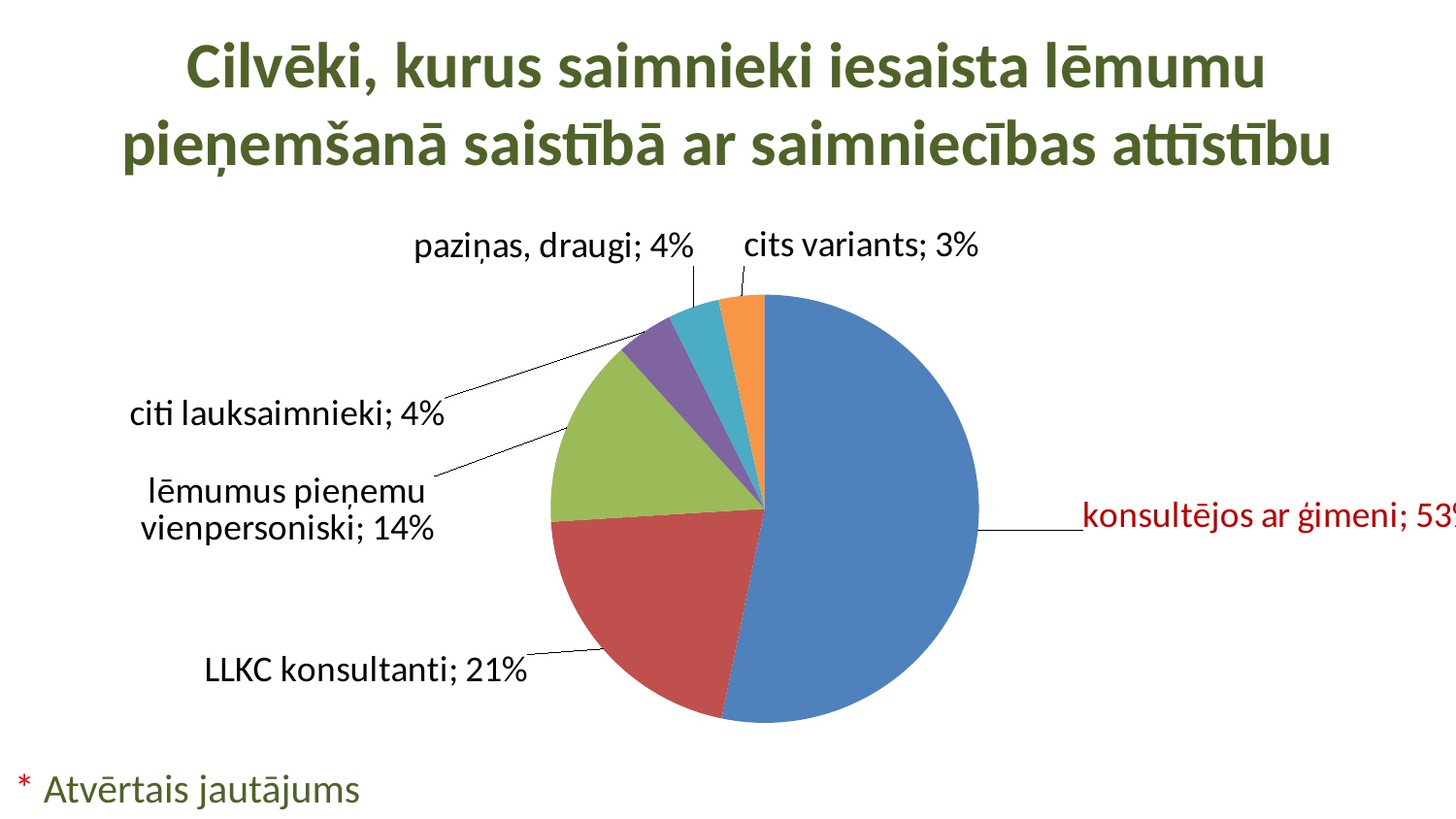
What share does the slice 'lēmumus pieņemu vienpersoniski' have? 14% What is the difference in percentage points between 'LLKC konsultanti' and 'lēmumus pieņemu vienpersoniski'? 7 percentage points How many slices does the pie chart have? 6 What percentage is shown for 'paziņas, draugi'? 4% What percentage of the pie is labelled 'LLKC konsultanti'? 21% What percentage is shown for 'konsultējos ar ģimeni'? 53% Which category has the largest slice of the pie? konsultējos ar ģimeni What type of chart is shown on the slide? pie chart Which is larger: the share for 'LLKC konsultanti' or for 'lēmumus pieņemu vienpersoniski'? LLKC konsultanti What colour is the slice for 'LLKC konsultanti'? red Which category has the smallest slice of the pie? cits variants What percentage is shown for 'cits variants'? 3%